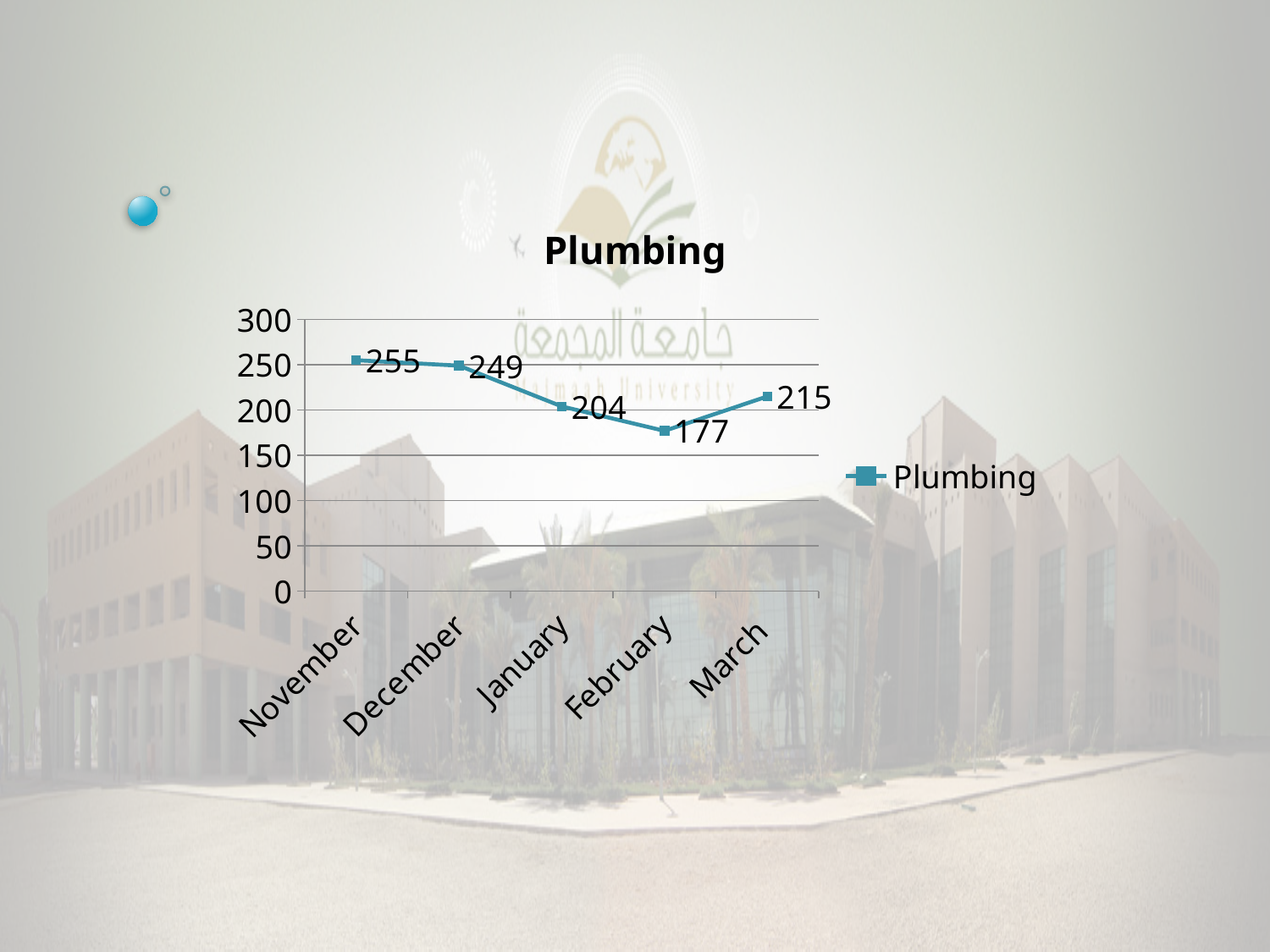
What is the Plumbing value for February? 177 Which is larger, the Plumbing value for January or for March? March What is the Plumbing value for November? 255 How many months are plotted on the chart? 5 What is the difference between the Plumbing values for January and December? 45 What is the difference between the Plumbing values for November and February? 78 Is the Plumbing value for December greater or less than 200? greater What kind of chart is shown on the slide? line chart What is the title of the chart? Plumbing Which month has the highest Plumbing value? November What is the Plumbing value for March? 215 Which month has the lowest Plumbing value? February